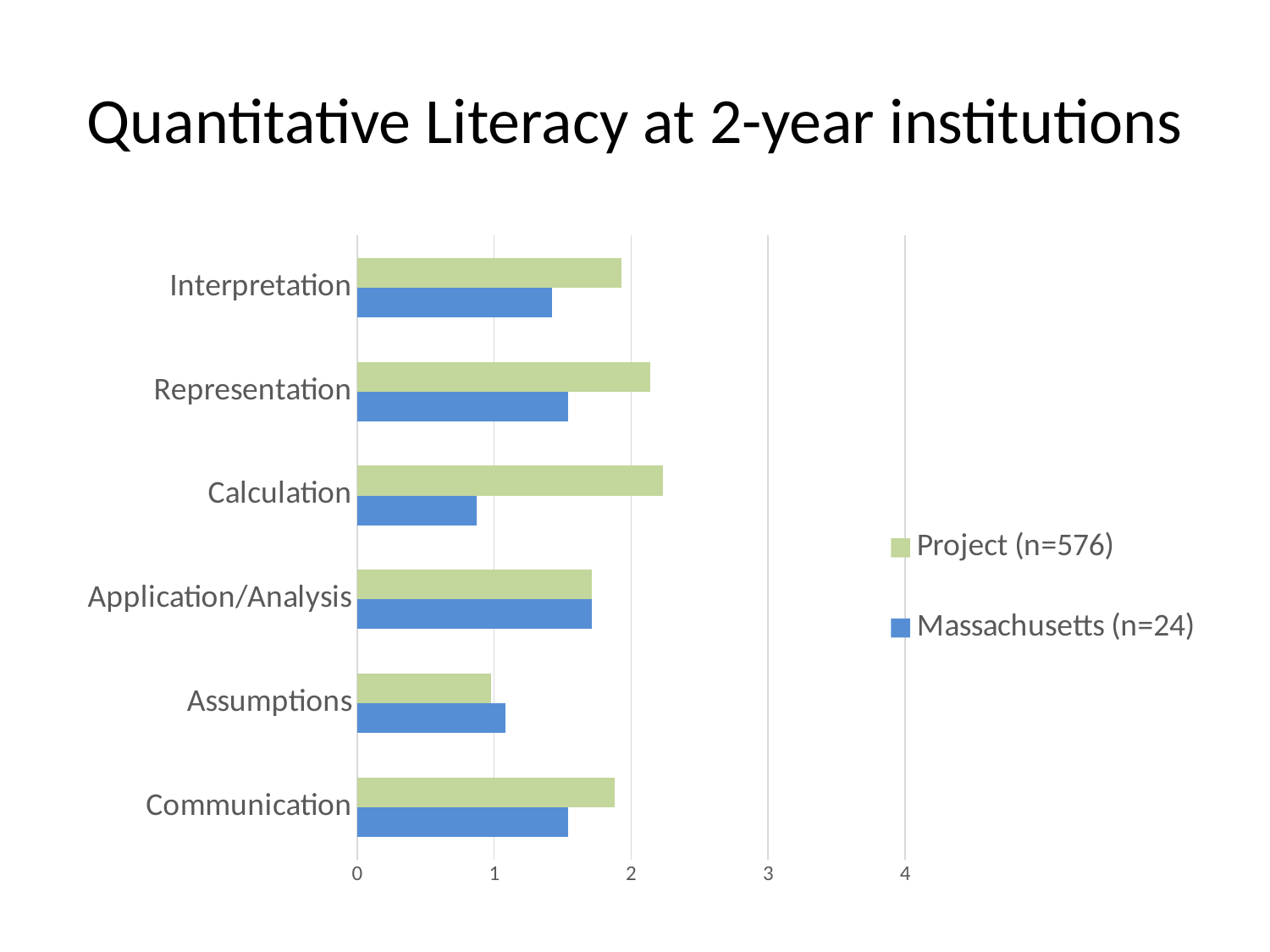
Is the Massachusetts (n=24) value for Calculation greater or less than 1? less Is the Project (n=576) value for Calculation greater or less than 2? greater What kind of chart is shown on the slide? bar chart What is the title of the slide? Quantitative Literacy at 2-year institutions Which category has the highest value for the Project (n=576) series? Calculation Which category has the highest value for the Massachusetts (n=24) series? Application/Analysis How many series does the legend list? 2 For Calculation, which series has the larger value, Project (n=576) or Massachusetts (n=24)? Project (n=576) How many categories are shown on the chart? 6 Which category has the lowest value for the Massachusetts (n=24) series? Calculation For Assumptions, which series has the larger value, Project (n=576) or Massachusetts (n=24)? Massachusetts (n=24) Which category has the lowest value for the Project (n=576) series? Assumptions